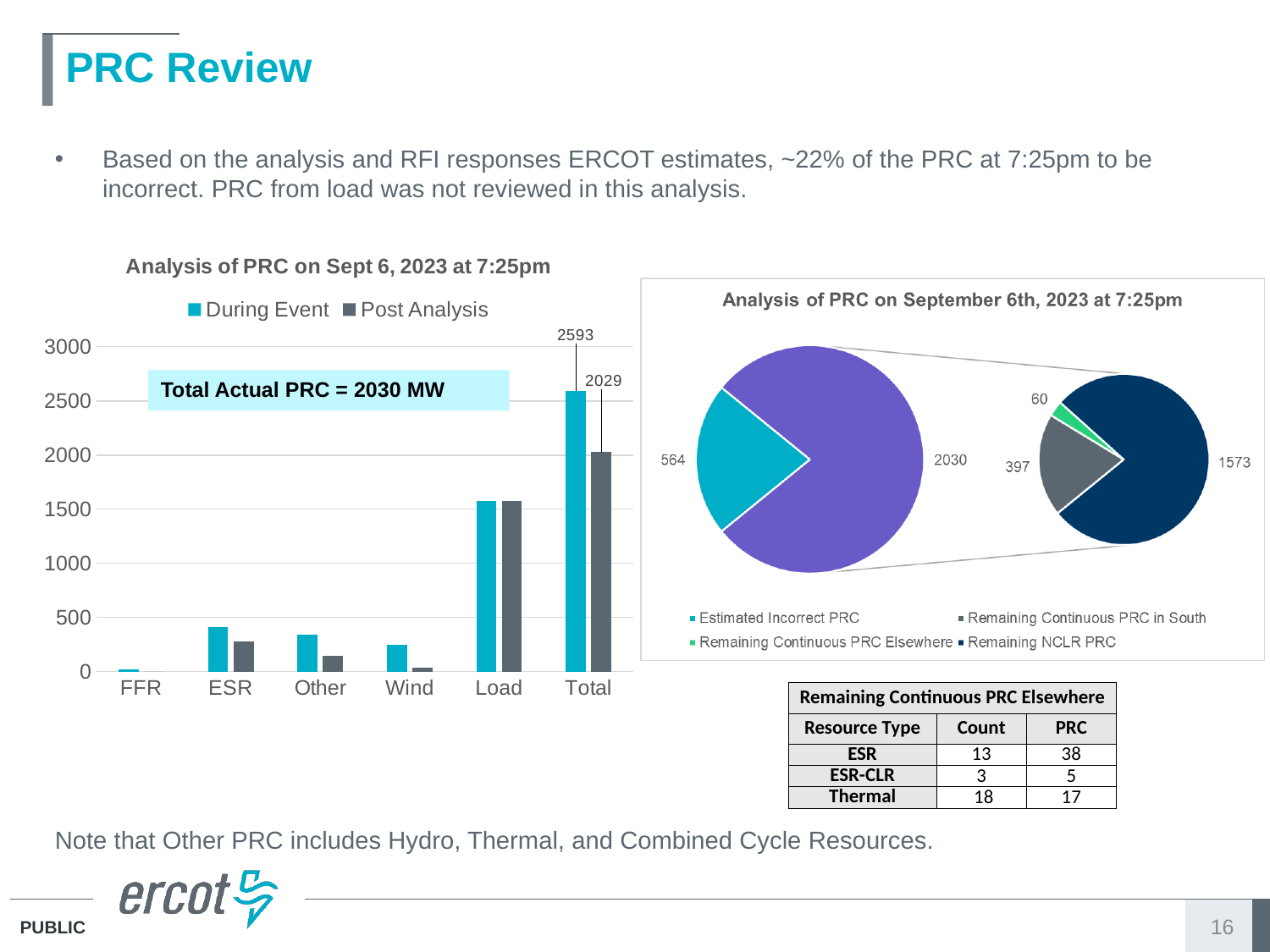
In the pie chart, what is the value for Remaining Continuous PRC in South? 397 In the pie chart, what is the value for Estimated Incorrect PRC? 564 How many series does the legend of the bar chart list? 2 In the bar chart, what is the difference between the During Event and Post Analysis values for Total? 564 In the bar chart, is the During Event value for ESR greater or less than 500? less How many categories are shown on the x axis of the bar chart? 6 What kind of chart is the chart on the left of the slide? bar chart In the bar chart, what is the During Event value for Total? 2593 In the pie chart, what is the value for Remaining Continuous PRC Elsewhere? 60 In the bar chart, which is larger for ESR: the During Event value or the Post Analysis value? During Event In the pie chart, what is the value for Remaining NCLR PRC? 1573 In the bar chart, what is the Post Analysis value for Total? 2029